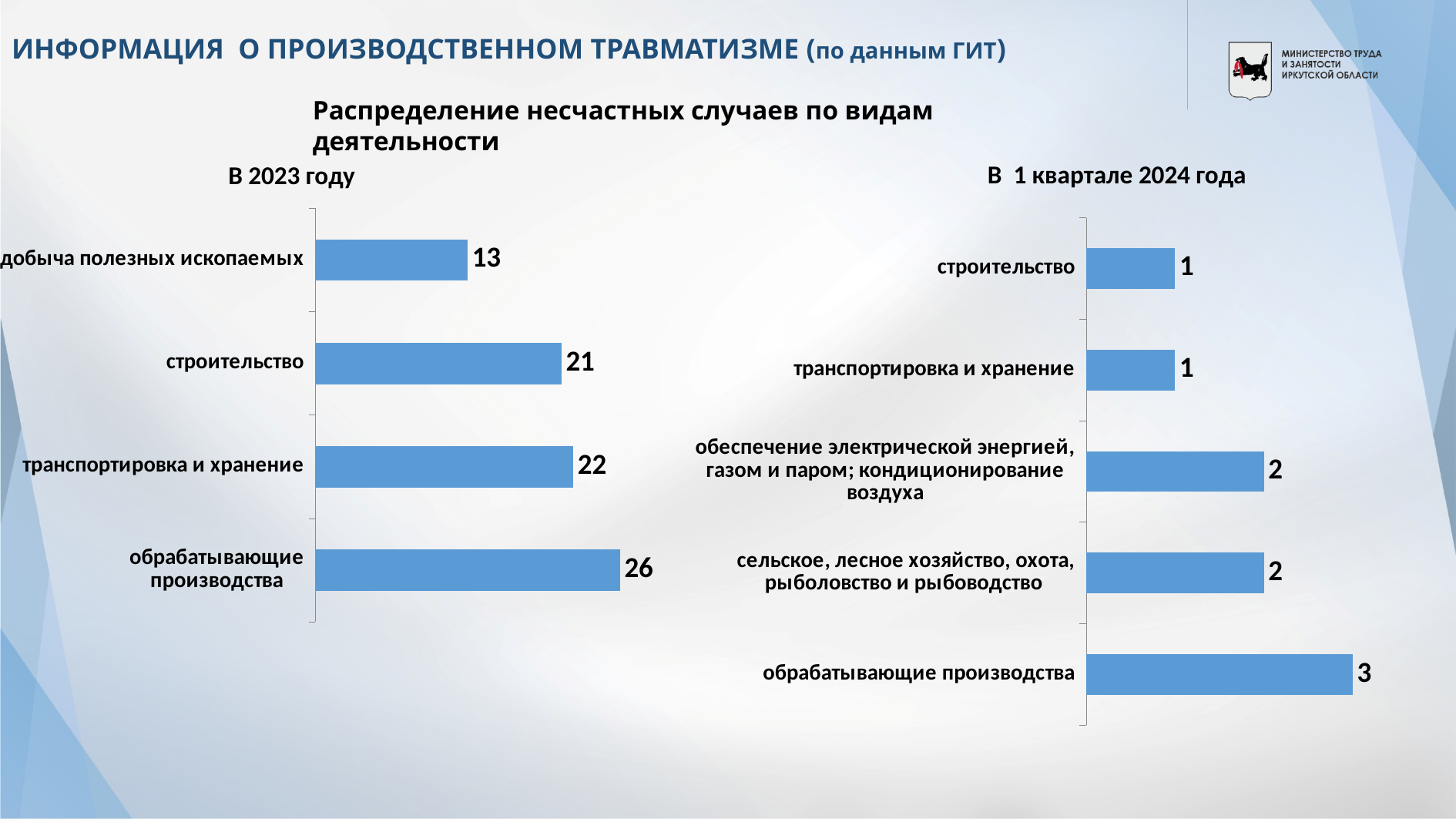
In the 'В 2023 году' chart, which is larger: транспортировка и хранение or строительство? транспортировка и хранение In the 'В 2023 году' chart, which category has the lowest value? добыча полезных ископаемых How many categories are shown in the 'В 1 квартале 2024 года' chart? 5 In the 'В 2023 году' chart, what is the value for добыча полезных ископаемых? 13 In the 'В 1 квартале 2024 года' chart, what is the value for сельское, лесное хозяйство, охота, рыболовство и рыбоводство? 2 What type of chart is the 'В 2023 году' chart? bar chart In the 'В 2023 году' chart, what is the value for строительство? 21 In the 'В 1 квартале 2024 года' chart, what is the value for обрабатывающие производства? 3 In the 'В 2023 году' chart, what is the difference between обрабатывающие производства and добыча полезных ископаемых? 13 In the 'В 2023 году' chart, which category has the highest value? обрабатывающие производства In the 'В 1 квартале 2024 года' chart, which category has the highest value? обрабатывающие производства How many categories are shown in the 'В 2023 году' chart? 4